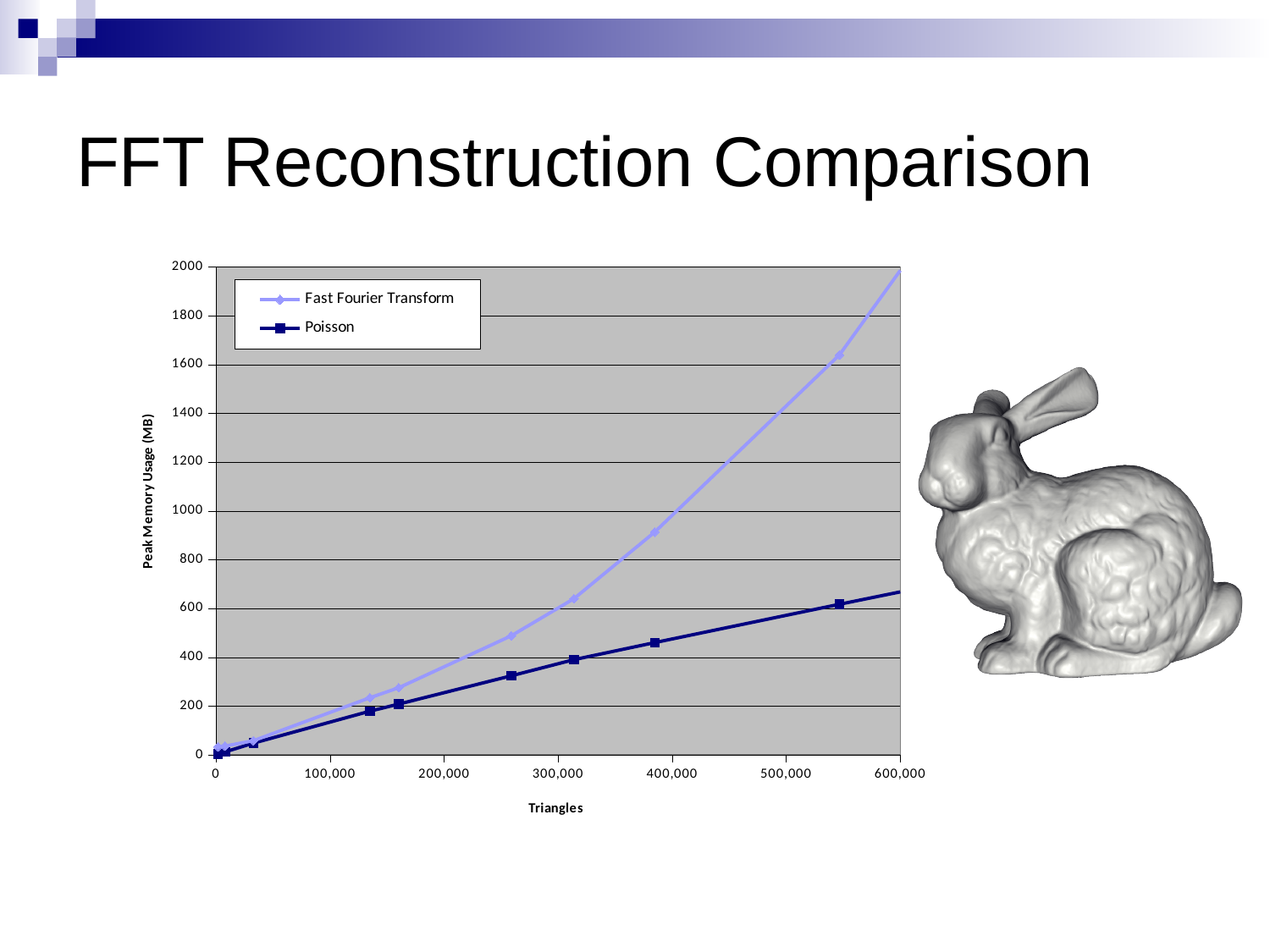
How many series does the chart's legend list? 2 Is the Fast Fourier Transform value at 600,000 triangles greater or less than 1800? greater Is the Poisson value at 600,000 triangles greater or less than 600? greater What is the label of the chart's vertical axis? Peak Memory Usage (MB) Does the Poisson peak memory usage rise or fall as the number of triangles increases? rise Is the Poisson value at 600,000 triangles greater or less than 800? less Which series has the higher peak memory usage at 600,000 triangles? Fast Fourier Transform Does the Fast Fourier Transform peak memory usage rise or fall as the number of triangles increases? rise What are the two series named in the chart's legend? Fast Fourier Transform and Poisson What kind of chart is shown on the slide? line chart